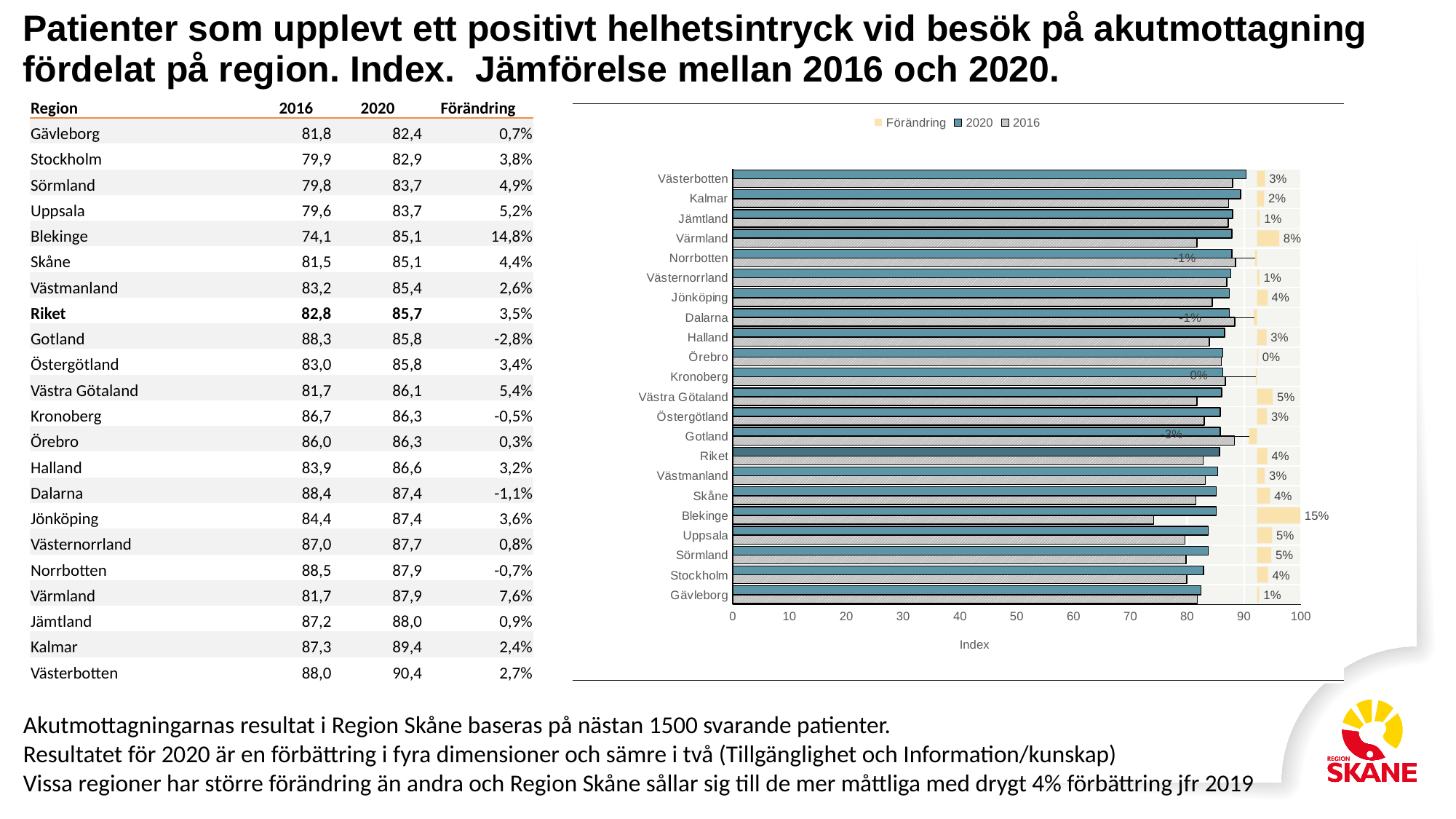
On the chart, is the 2020 value for Gävleborg greater or less than 90? less On the chart, which has the larger 2020 value, Västerbotten or Gävleborg? Västerbotten Which region has the highest Förändring value on the chart? Blekinge How many series does the chart's legend list? 3 What is the title of the chart's horizontal axis? Index What Förändring value is labelled for Blekinge on the chart? 15% What Förändring value is labelled for Skåne on the chart? 4% What Förändring value is labelled for Värmland on the chart? 8% How many regions (categories) are plotted on the chart's vertical axis? 22 What kind of chart is shown on the right of the slide? bar chart What Förändring value is labelled for Gotland on the chart? -3% On the chart, is the 2016 value for Blekinge greater or less than 80? less